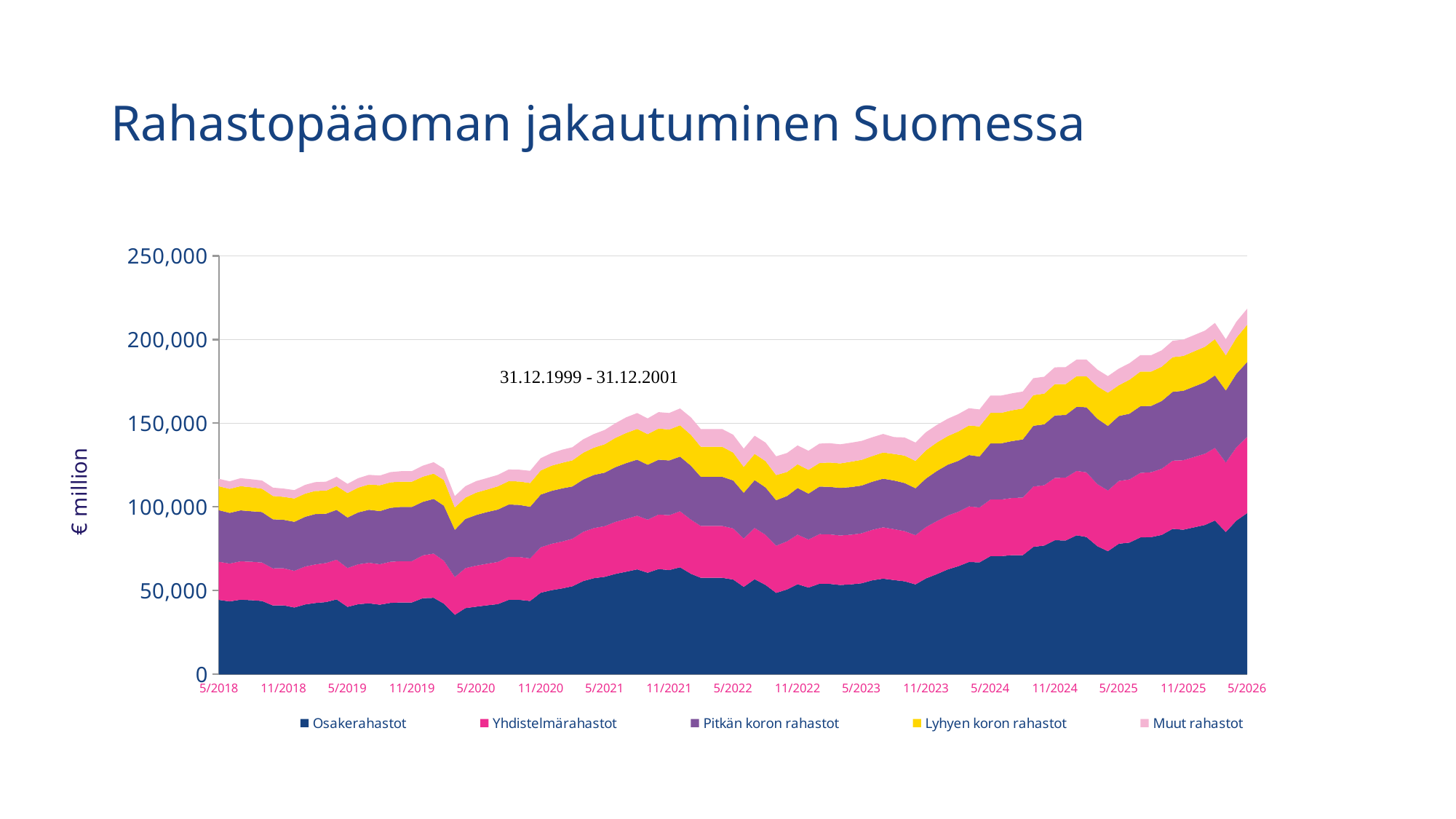
What is the label on the vertical axis? € million How many date labels are shown on the x axis? 17 Which series has the larger value at 5/2026, Osakerahastot or Muut rahastot? Osakerahastot Is the total fund capital at 5/2026 greater or less than 200,000? greater Is the total fund capital at 5/2023 greater or less than 150,000? less Does the total fund capital rise or fall overall from 5/2018 to 5/2026? rise Is the total fund capital at 5/2018 greater or less than 150,000? less What is the title of the chart? Rahastopääoman jakautuminen Suomessa At which x-axis date is the total fund capital highest? 5/2026 How many series does the legend list? 5 What kind of chart is shown on the slide? Stacked area chart